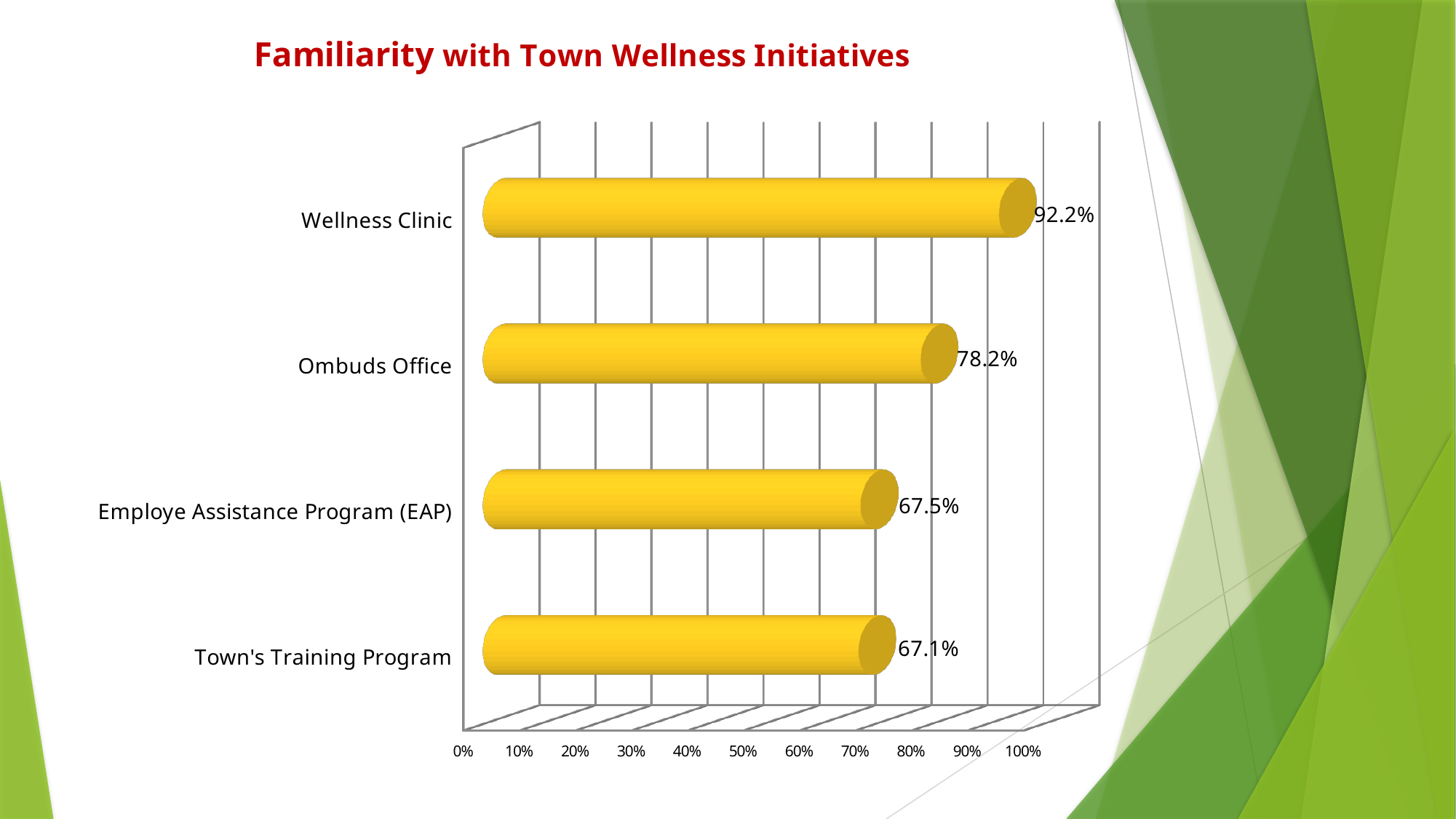
What is the title of the chart? Familiarity with Town Wellness Initiatives What is the difference between the values for Wellness Clinic and Ombuds Office? 14.0% What is the value for Wellness Clinic? 92.2% What is the difference between the values for Ombuds Office and Town's Training Program? 11.1% How many categories are shown in the chart? 4 What is the value for Ombuds Office? 78.2% Is the value for Ombuds Office greater or less than 70%? greater Which category has the highest value? Wellness Clinic Which is larger, the value for Ombuds Office or the value for Employe Assistance Program (EAP)? Ombuds Office What kind of chart is shown on the slide? Bar chart What is the value for Employe Assistance Program (EAP)? 67.5% What is the value for Town's Training Program? 67.1%